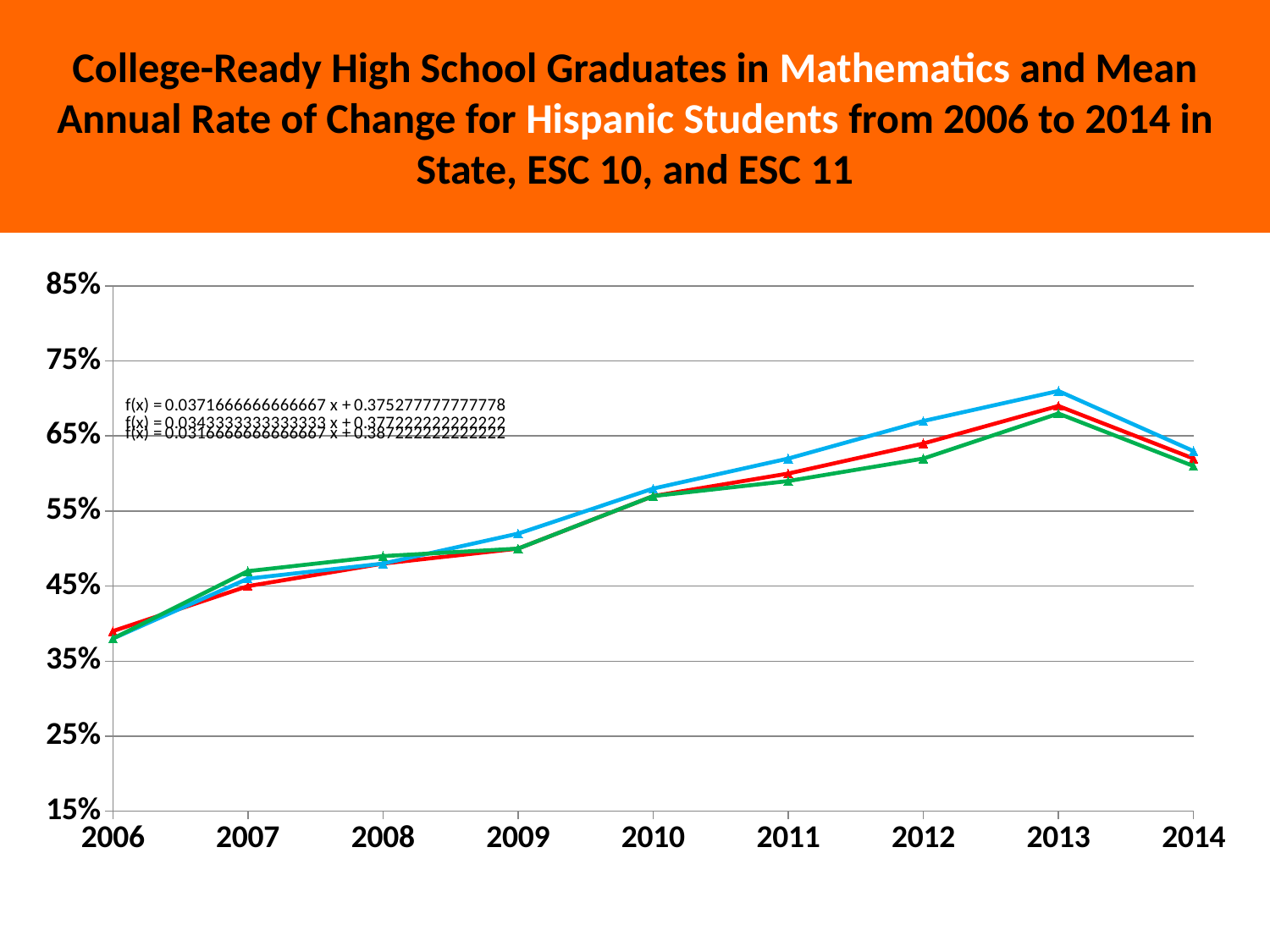
In which year does the red line have its lowest value? 2006 Which three regions does the chart title say are compared? State, ESC 10, and ESC 11 How many years are plotted along the x axis? 9 Is the value of the blue line in 2013 greater or less than 65%? greater Is the value of the red line in 2014 greater or less than 65%? less In which year does the blue line reach its highest value? 2013 What kind of chart is shown on the slide? line chart Do the lines generally rise or fall from 2006 to 2013? rise Is the value of the green line in 2006 greater or less than 45%? less How many lines are plotted on the chart? 3 In 2013, which line is higher, the blue line or the green line? blue